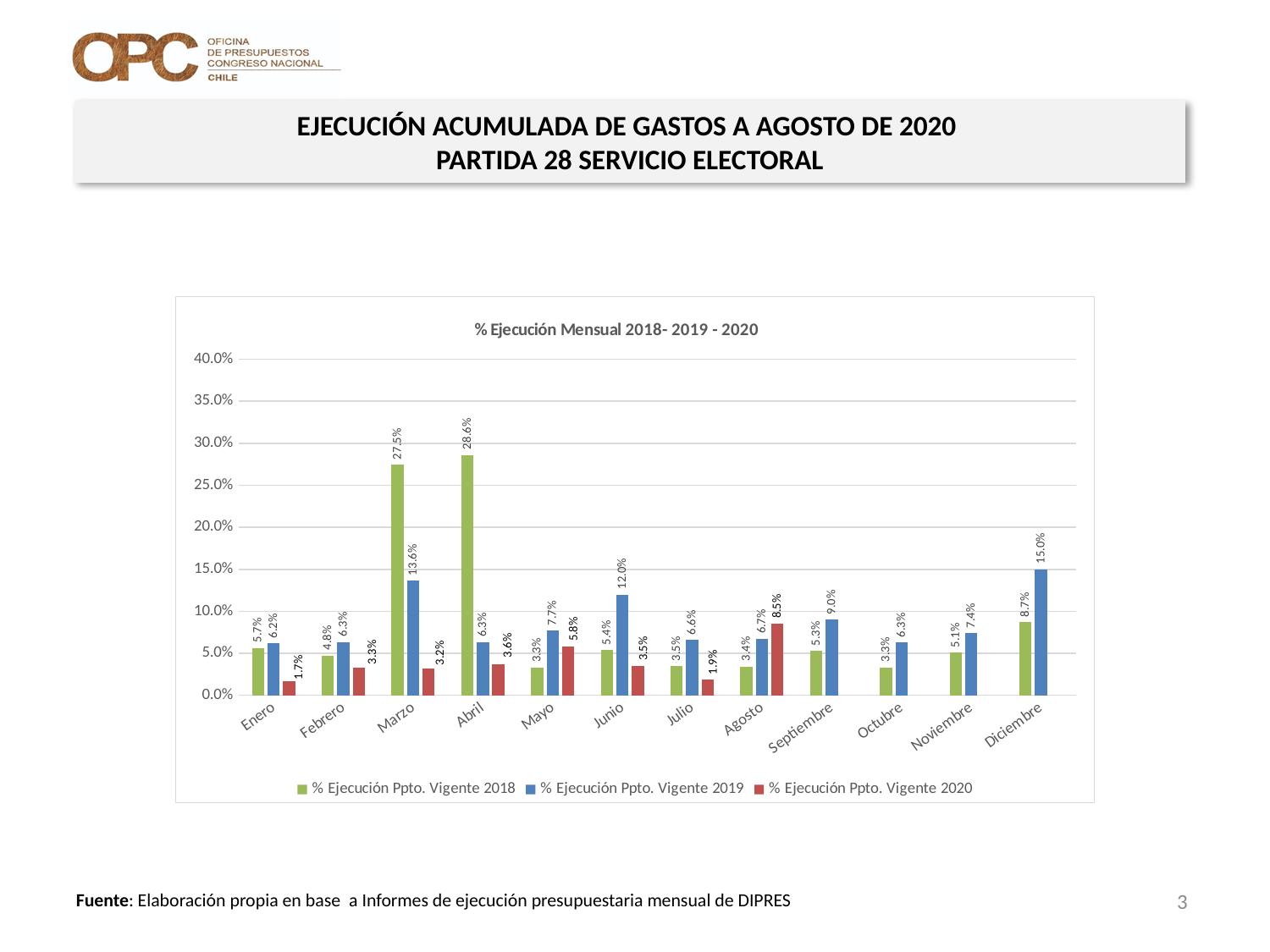
What is the difference between the 2018 and 2019 values for Marzo? 13.9% What kind of chart is shown on the slide? Bar chart What is the value for Agosto in the % Ejecución Ppto. Vigente 2020 series? 8.5% Is the value for Abril in the % Ejecución Ppto. Vigente 2018 series greater or less than 25.0%? greater How many series does the legend list? 3 What is the title of the chart? % Ejecución Mensual 2018- 2019 - 2020 Which month has the lowest value in the % Ejecución Ppto. Vigente 2020 series? Enero How many months are shown on the x axis? 12 What is the value for Marzo in the % Ejecución Ppto. Vigente 2018 series? 27.5% For Junio, which series has the larger value: % Ejecución Ppto. Vigente 2018 or % Ejecución Ppto. Vigente 2019? % Ejecución Ppto. Vigente 2019 Which month has the highest value in the % Ejecución Ppto. Vigente 2018 series? Abril What is the value for Diciembre in the % Ejecución Ppto. Vigente 2019 series? 15.0%